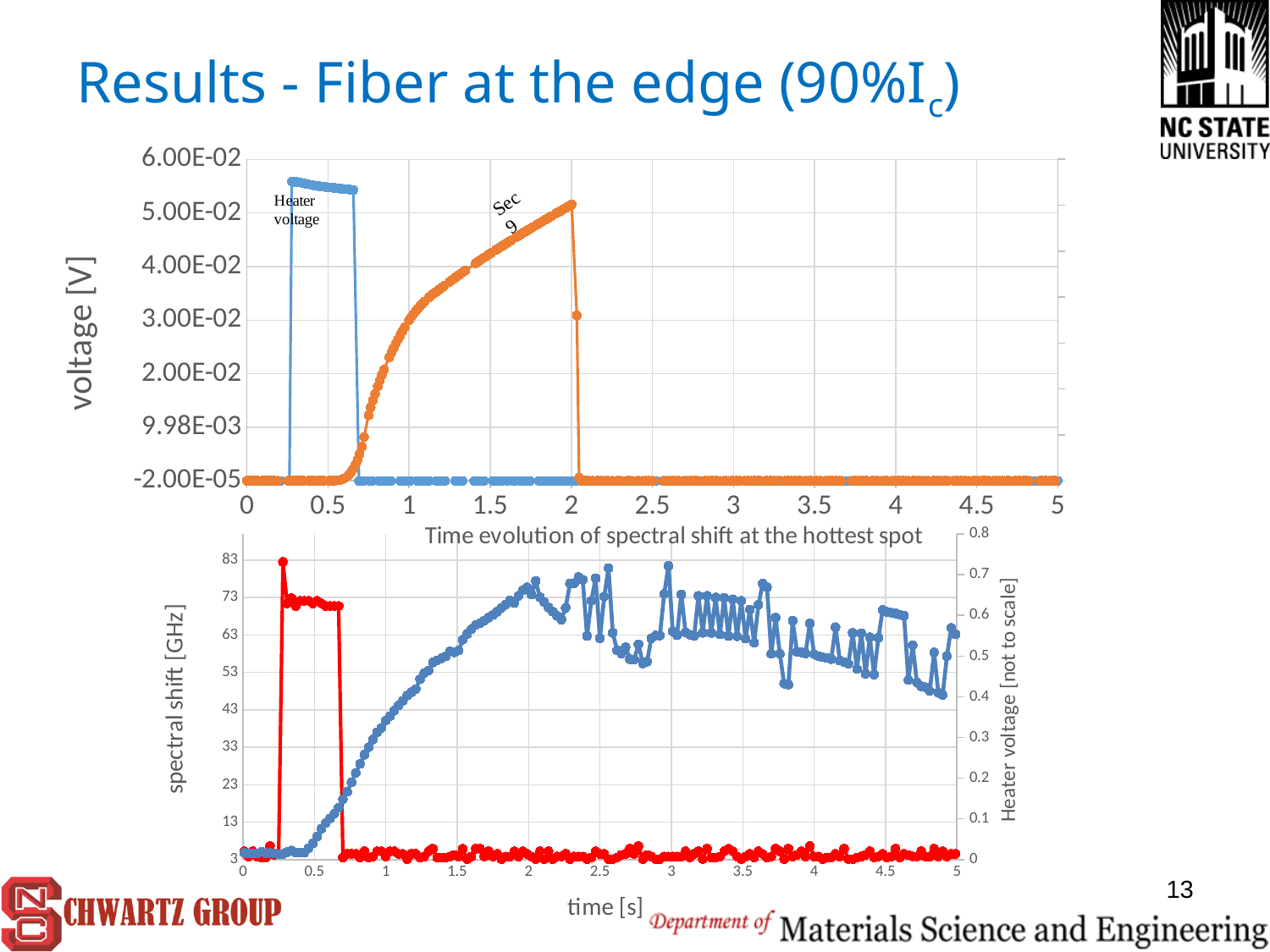
In the top chart, is the Heater voltage plateau (between about 0.3 s and 0.7 s) greater or less than 5.00E-02? greater In the top chart, is the peak value of the Sec 9 series (around 2 s) greater or less than 4.00E-02? greater In the bottom chart, is the peak heater voltage (red series, read on the right axis) greater or less than 0.6? greater What is the title of the bottom chart? Time evolution of spectral shift at the hottest spot In the top chart, does the Sec 9 series rise or fall between 0.7 s and 2 s? rise In the top chart, at 0.5 s, which series has the higher value: Heater voltage or Sec 9? Heater voltage What type of chart is the top chart on the slide? line chart What type of chart is the bottom chart titled 'Time evolution of spectral shift at the hottest spot'? line chart What is the y-axis label of the top chart? voltage [V]